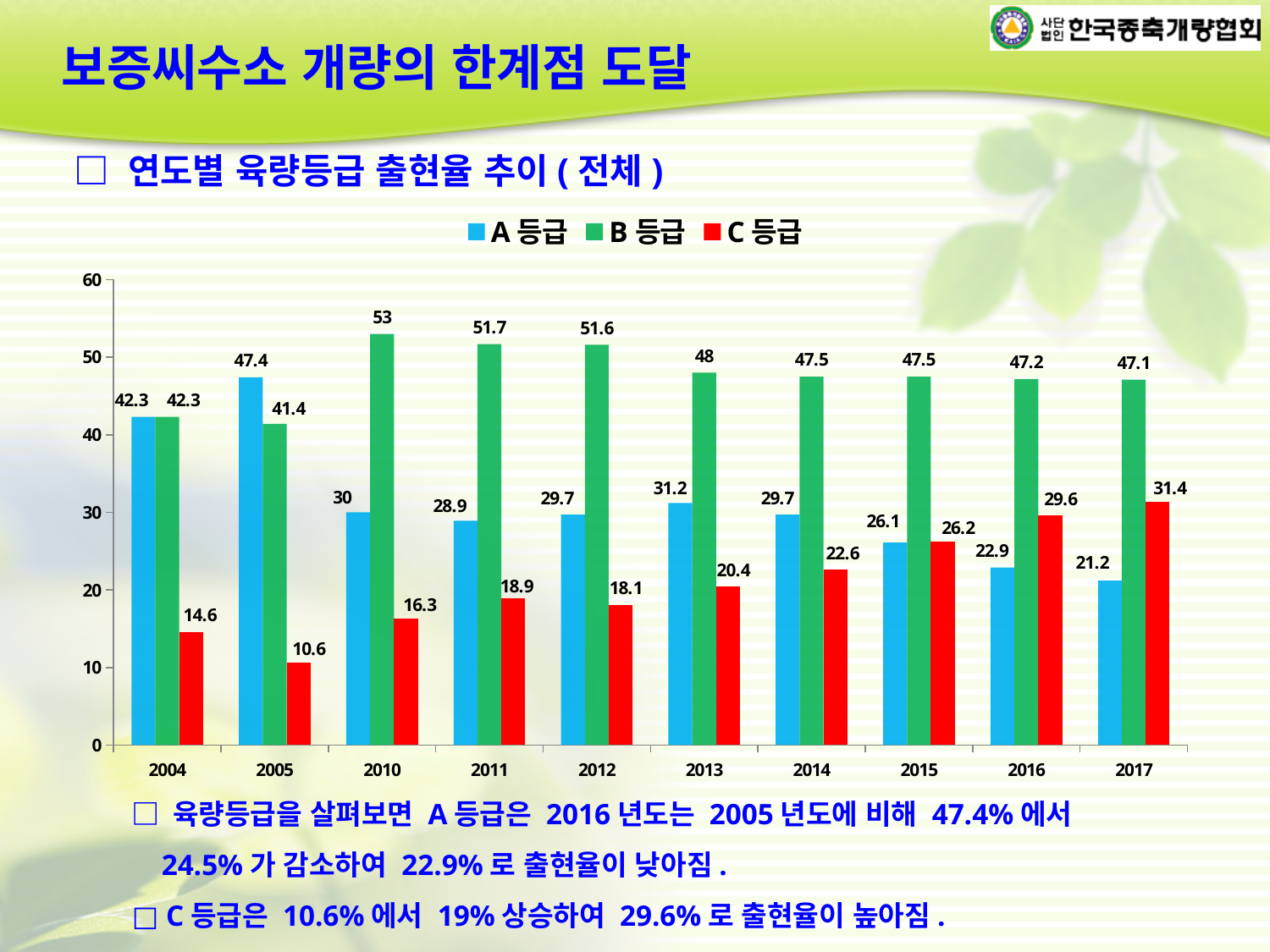
In which year is C 등급 lowest? 2005 What is the difference between B 등급 and A 등급 in 2010? 23 Which is larger in 2015, A 등급 or C 등급? C 등급 What is the value of A 등급 in 2005? 47.4 In which year is B 등급 highest? 2010 What is the value of B 등급 in 2012? 51.6 Does C 등급 rise or fall from 2010 to 2017? Rise How many series does the legend list? 3 What kind of chart is shown on the slide? Bar chart How many years are shown on the x axis? 10 What is the value of C 등급 in 2017? 31.4 What colour represents C 등급 in the chart? Red